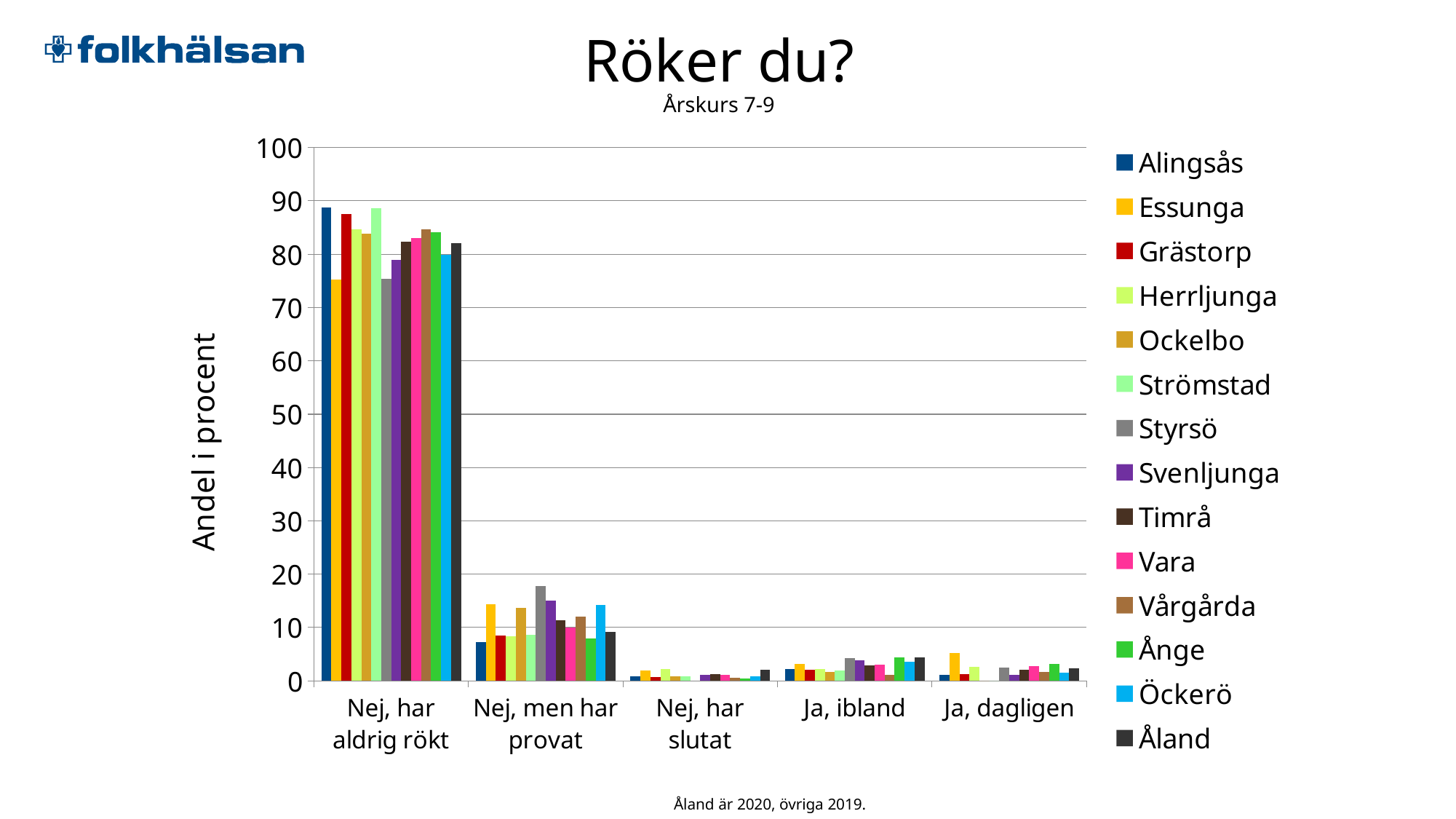
What is the title of the chart? Röker du? What kind of chart is shown on the slide? Bar chart Is the value for Essunga in the category "Nej, har aldrig rökt" greater or less than 80? less Which category on the x axis has the tallest bars for all series? Nej, har aldrig rökt Is the value for Alingsås in the category "Nej, men har provat" greater or less than 10? less Which series has the highest value in the category "Nej, men har provat"? Styrsö How many answer categories are shown on the x axis? 5 What is the label on the y axis? Andel i procent In the category "Nej, har aldrig rökt", which is larger: the value for Alingsås or the value for Essunga? Alingsås Is the value for Styrsö in the category "Nej, men har provat" greater or less than 10? greater How many series does the legend list? 14